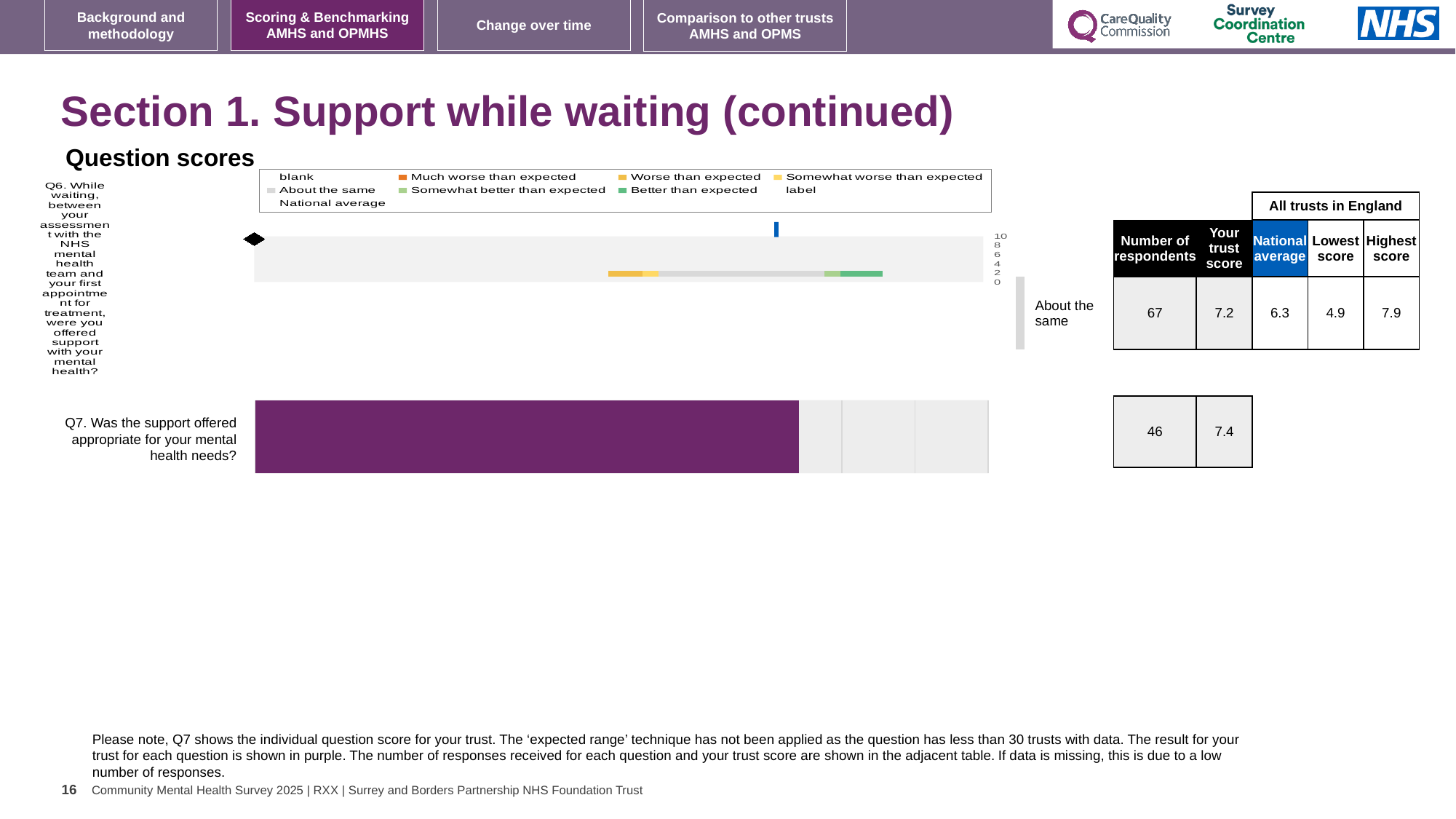
How many questions are plotted in the question scores chart? 2 How many respondents answered Q7? 46 Which expected-range category is Q6 placed in, according to the label next to its bar? About the same What colour is the bar for Q7 in the chart? purple What kind of chart is used to show the question scores on this slide? bar chart Which is larger for Q6, the trust score or the national average? trust score What is the difference between the trust score and the national average for Q6? 0.9 What is the national average score for Q6? 6.3 What is the trust score for Q7? 7.4 What is the difference between the highest score and the lowest score for Q6 across all trusts in England? 3.0 How many more respondents answered Q6 than Q7? 21 What is the trust score for Q6 shown in the table beside the chart? 7.2